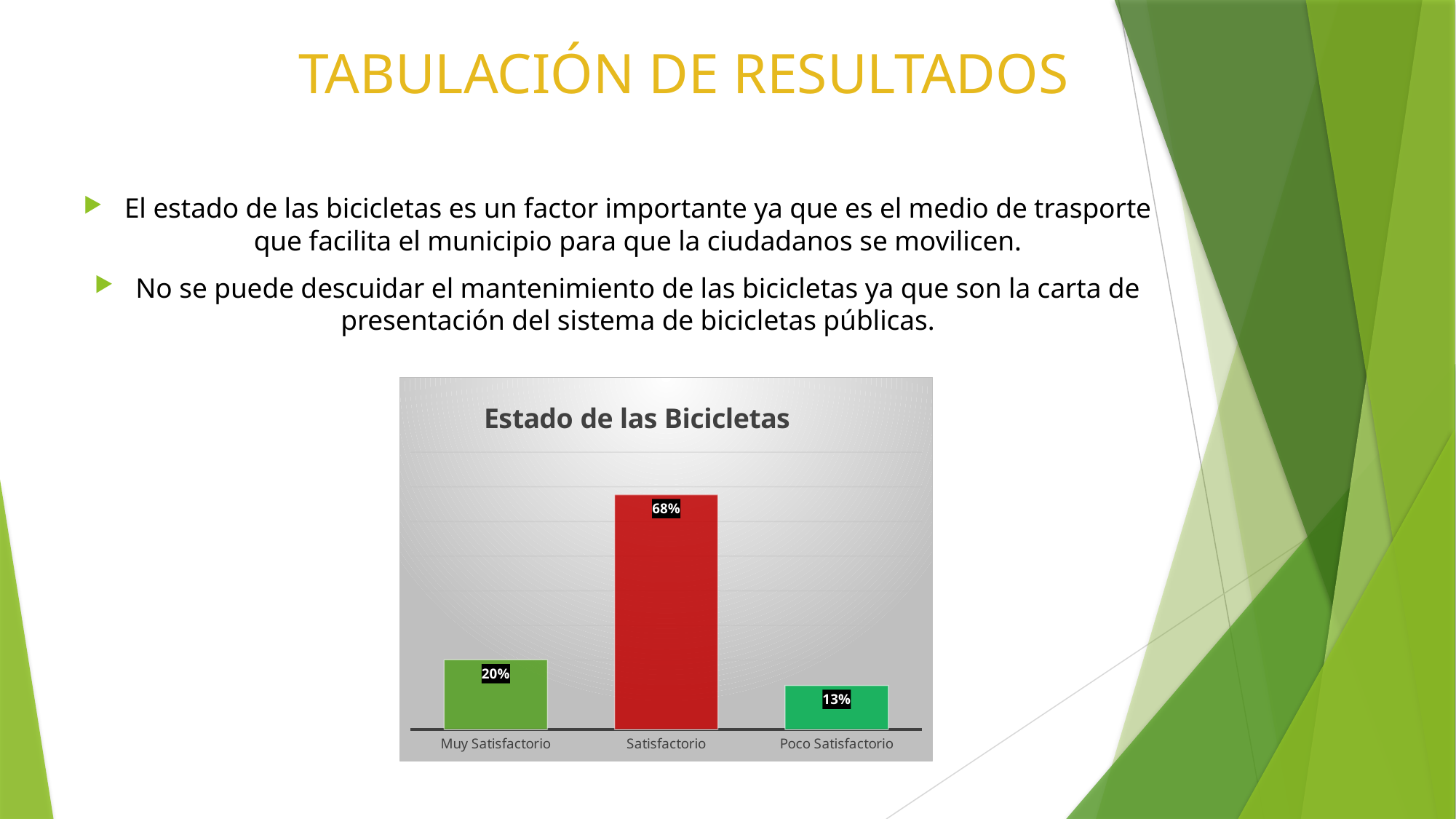
What is the value for Poco Satisfactorio in the Estado de las Bicicletas chart? 13% Which category has the lowest value in the Estado de las Bicicletas chart? Poco Satisfactorio What is the difference between the values for Satisfactorio and Muy Satisfactorio? 48% Which is larger, the value for Muy Satisfactorio or the value for Poco Satisfactorio? Muy Satisfactorio What is the value for Muy Satisfactorio in the Estado de las Bicicletas chart? 20% What is the difference between the values for Muy Satisfactorio and Poco Satisfactorio? 7% How many categories are shown in the Estado de las Bicicletas chart? 3 What kind of chart is shown on the slide? Bar chart Which category has the highest value in the Estado de las Bicicletas chart? Satisfactorio What is the value for Satisfactorio in the Estado de las Bicicletas chart? 68% What is the title of the chart on the slide? Estado de las Bicicletas What colour is the bar for Satisfactorio? Red